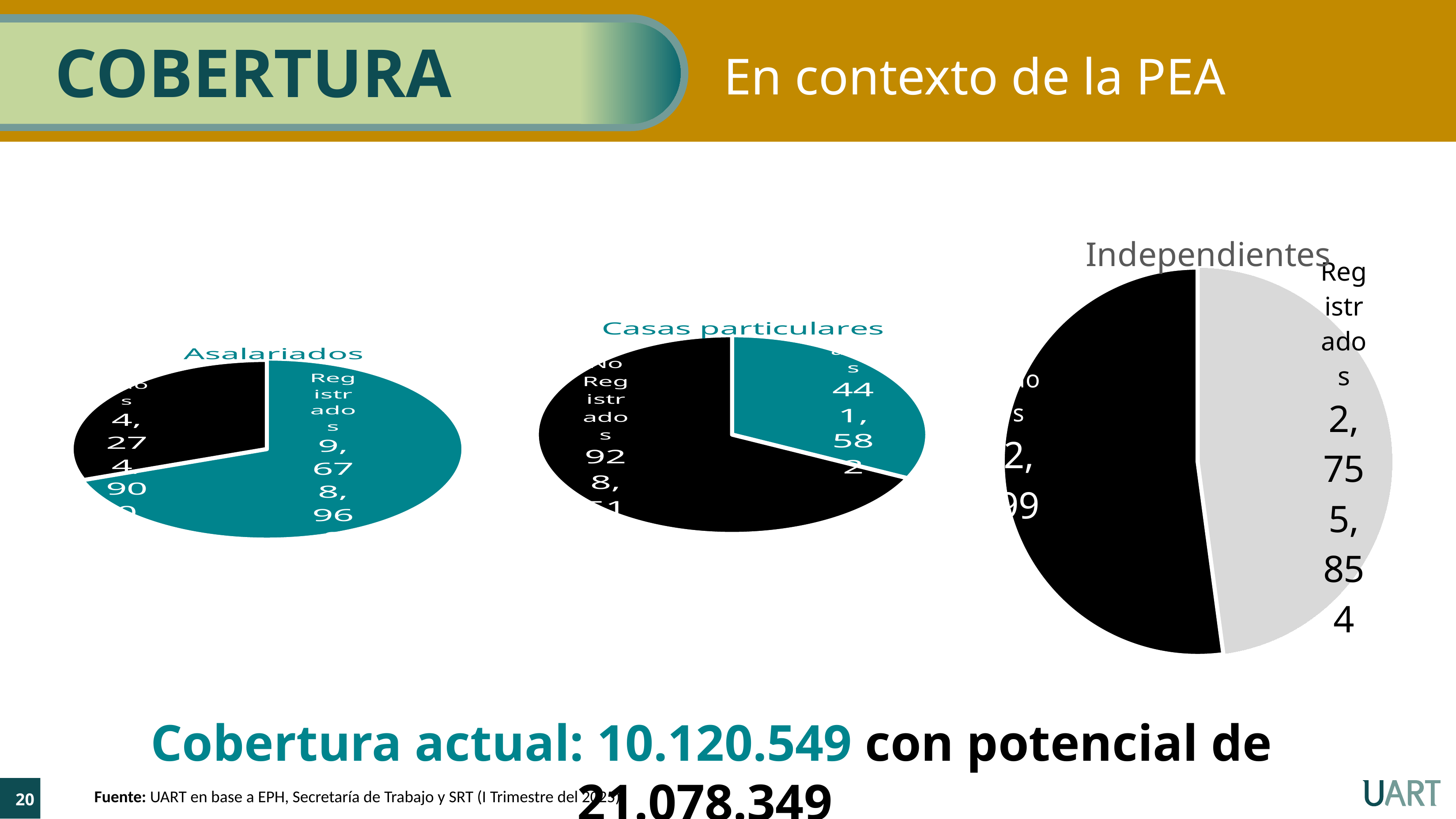
In the 'Independientes' chart, what is the value for Registrados? 2,755,854 What kind of chart is the 'Asalariados' chart? pie chart In the 'Casas particulares' chart, which category has the smallest slice? Registrados What colour is the Registrados slice in the 'Casas particulares' chart? teal In the 'Casas particulares' chart, which slice is larger, Registrados or No Registrados? No Registrados How many slices does the 'Casas particulares' pie chart have? 2 In the 'Asalariados' chart, which category has the largest slice? Registrados What kind of chart is the 'Independientes' chart? pie chart In the 'Casas particulares' chart, what is the value for Registrados? 441,582 How many pie charts are shown on the slide? 3 In the 'Asalariados' chart, which slice is larger, Registrados or No Registrados? Registrados What is the title of the rightmost pie chart? Independientes